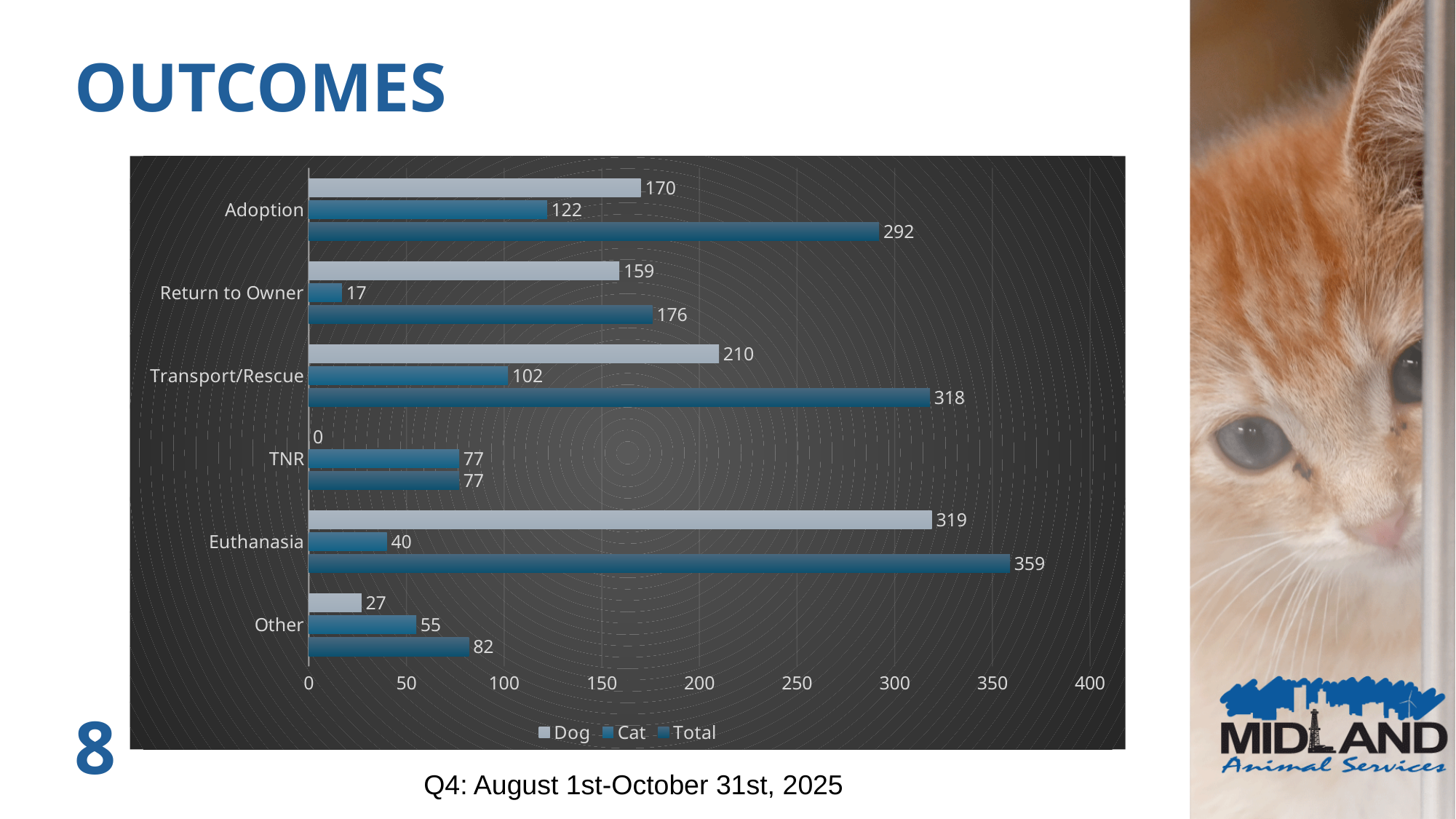
Which category has the highest Total value? Euthanasia Is the Total value for Adoption greater or less than 250? greater How many series does the legend list? 3 What kind of chart is shown on the slide? bar chart What is the Dog value for Adoption? 170 What is the difference between the Dog and Cat values for Euthanasia? 279 Which is larger, the Cat value for Adoption or the Cat value for Transport/Rescue? Adoption How many outcome categories are shown on the chart? 6 What period does the caption below the chart say the data covers? Q4: August 1st-October 31st, 2025 What is the Cat value for Return to Owner? 17 What is the Total value for Transport/Rescue? 318 Which category has the lowest Dog value? TNR